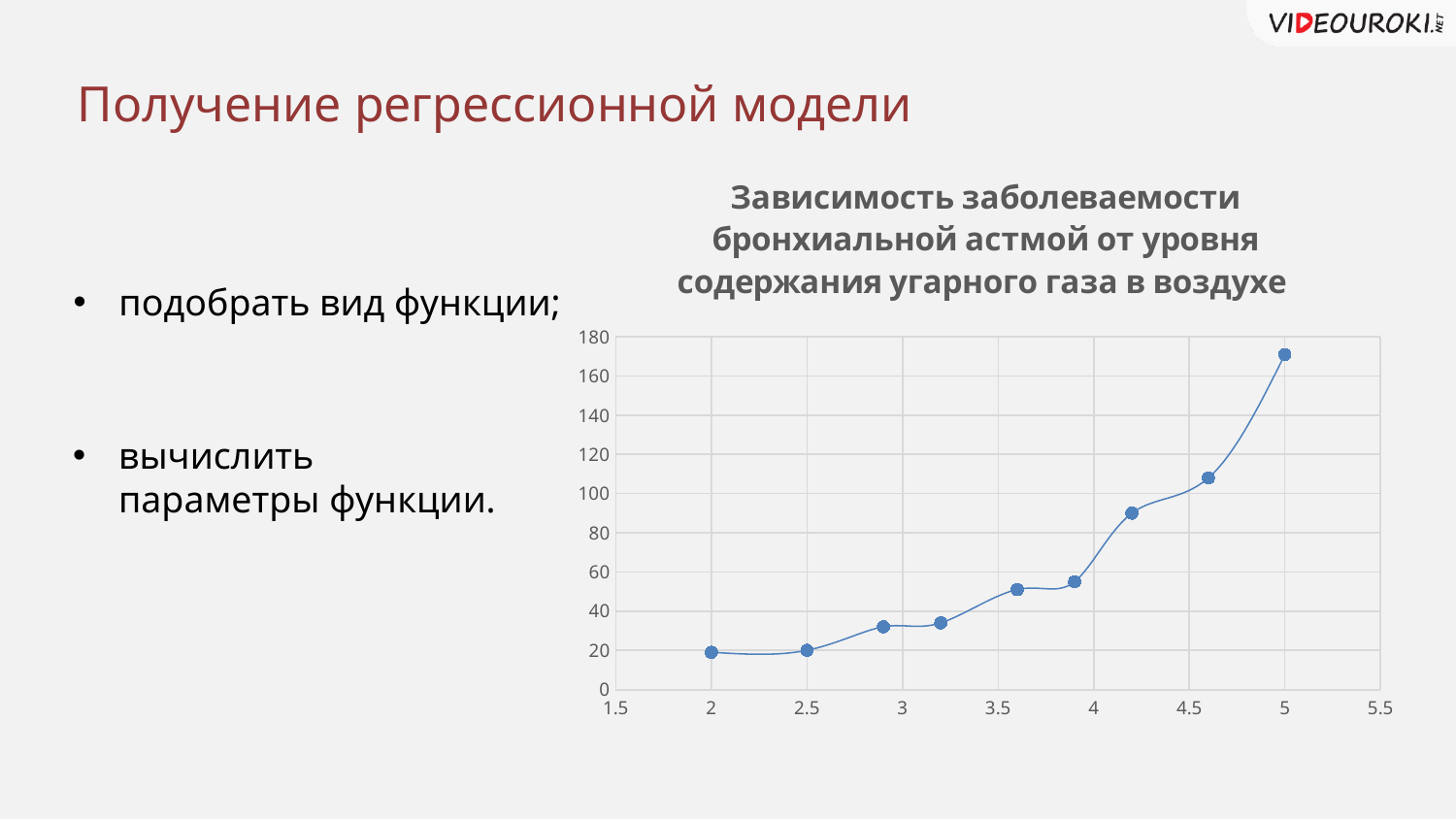
Do the plotted values rise or fall as the x value increases from 2 to 5? rise Is the value at x = 5 greater or less than 160? greater What kind of chart is shown on the slide? scatter chart with a smoothed line Is the value at x = 4.6 greater or less than 100? greater Is the value at x = 2.9 greater or less than 40? less What is the highest value shown on the vertical axis? 180 At which x value is the plotted value highest? 5 Which is larger: the value at x = 4.2 or the value at x = 3.6? the value at x = 4.2 How many data points are plotted on the chart? 9 What is the title of the chart? Зависимость заболеваемости бронхиальной астмой от уровня содержания угарного газа в воздухе